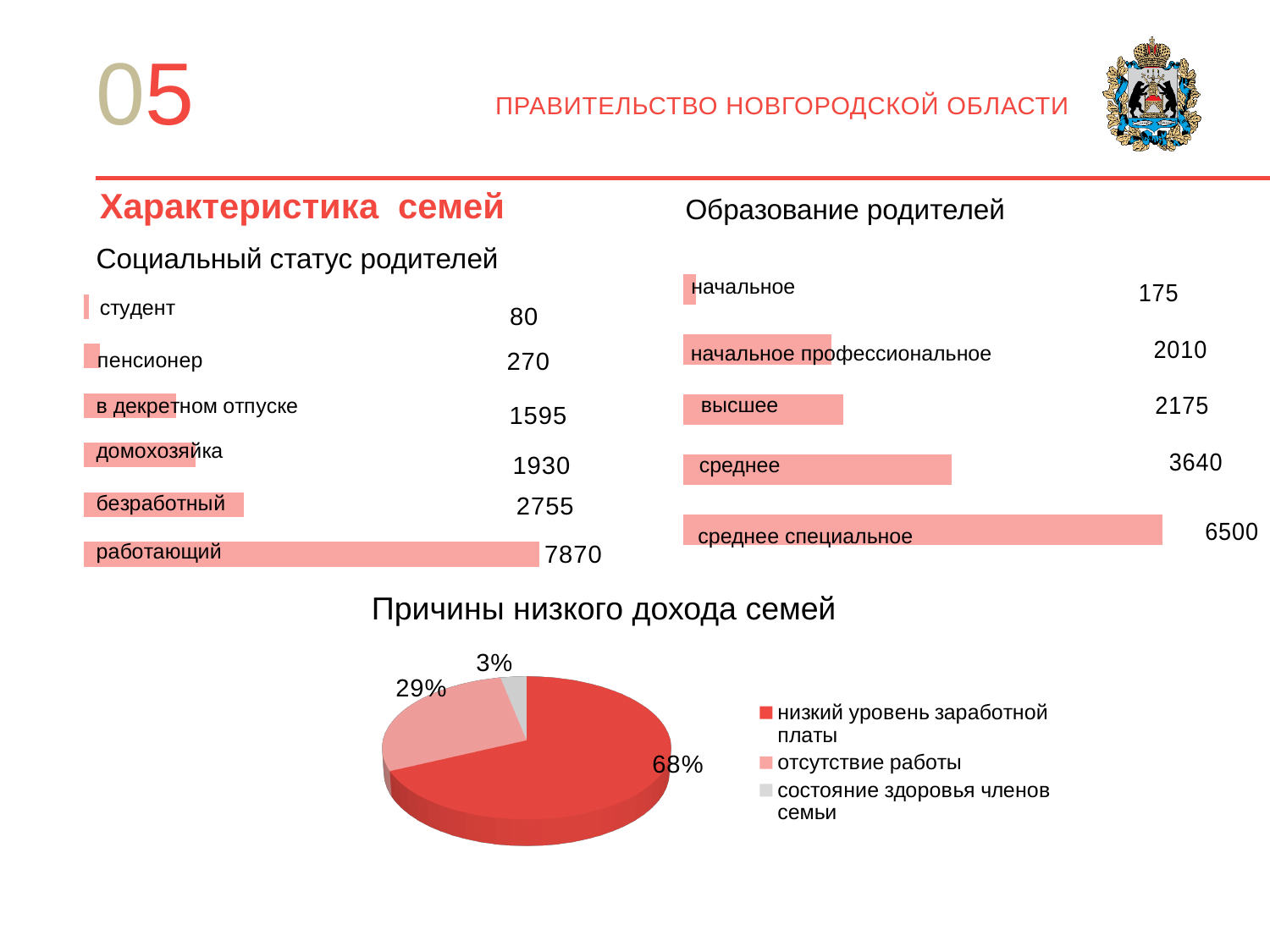
In the 'Социальный статус родителей' chart, what is the value for 'работающий'? 7870 In the 'Причины низкого дохода семей' chart, what share does 'отсутствие работы' have? 29% In the 'Социальный статус родителей' chart, which category has the lowest value? студент In the 'Образование родителей' chart, which category has the highest value? среднее специальное What kind of chart is the 'Причины низкого дохода семей' chart? pie chart In the 'Причины низкого дохода семей' chart, which slice is the largest? низкий уровень заработной платы In the 'Социальный статус родителей' chart, what is the difference between 'безработный' and 'домохозяйка'? 825 How many entries does the legend of the 'Причины низкого дохода семей' chart list? 3 In the 'Образование родителей' chart, which is larger: 'высшее' or 'начальное профессиональное'? высшее In the 'Образование родителей' chart, what is the difference between 'среднее специальное' and 'среднее'? 2860 In the 'Образование родителей' chart, what is the value for 'среднее'? 3640 In the 'Социальный статус родителей' chart, how many categories are shown? 6